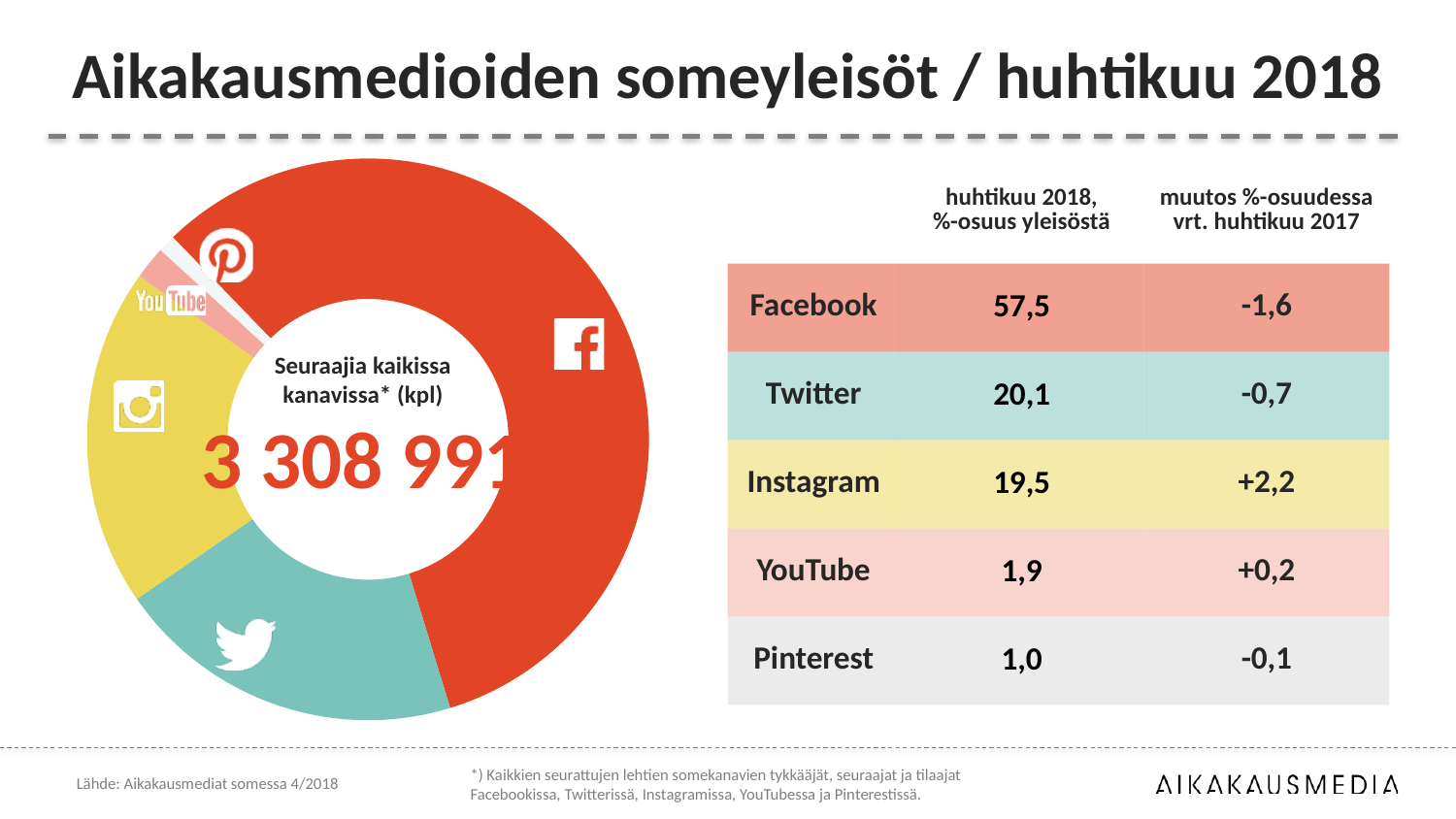
What is Facebook's %-share of the audience in April 2018? 57,5 Which channel had the largest positive change in %-share compared with April 2017? Instagram What kind of chart is shown on the left of the slide? donut (pie) chart Which channel has the largest share of the audience in April 2018? Facebook What is the difference between Facebook's and Twitter's %-share in April 2018? 37,4 How many social media channels are shown as slices in the donut chart? 5 What is the change in %-share for Instagram compared with April 2017? +2,2 What is Instagram's %-share of the audience in April 2018? 19,5 Which has the larger %-share in April 2018, Twitter or Instagram? Twitter What is the title of the slide? Aikakausmedioiden someyleisöt / huhtikuu 2018 Which channel has the smallest share of the audience in April 2018? Pinterest What is the change in %-share for Facebook compared with April 2017? -1,6